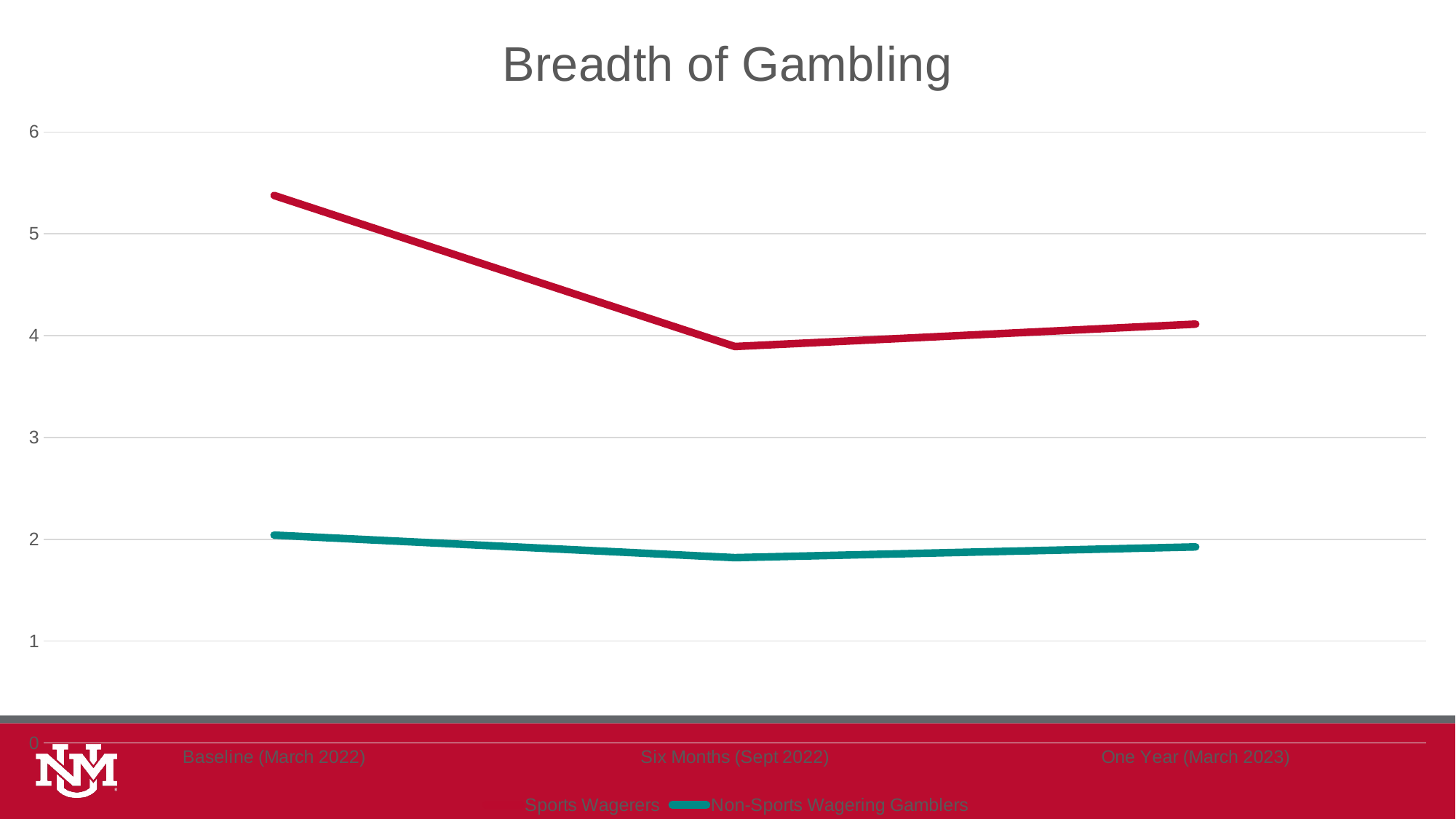
Is the value for Sports Wagerers at Baseline (March 2022) greater or less than 5? greater At which time point is the Sports Wagerers value lowest? Six Months (Sept 2022) What kind of chart is shown on the slide? Line chart What is the title of the chart? Breadth of Gambling Does the Sports Wagerers line rise or fall from Baseline (March 2022) to Six Months (Sept 2022)? fall At which time point is the Sports Wagerers value highest? Baseline (March 2022) How many time points are plotted along the x axis? 3 At which time point is the Non-Sports Wagering Gamblers value lowest? Six Months (Sept 2022) Which series has the larger value at One Year (March 2023), Sports Wagerers or Non-Sports Wagering Gamblers? Sports Wagerers Is the value for Non-Sports Wagering Gamblers at Six Months (Sept 2022) greater or less than 2? less How many series does the legend list? 2 Which series is drawn in teal? Non-Sports Wagering Gamblers